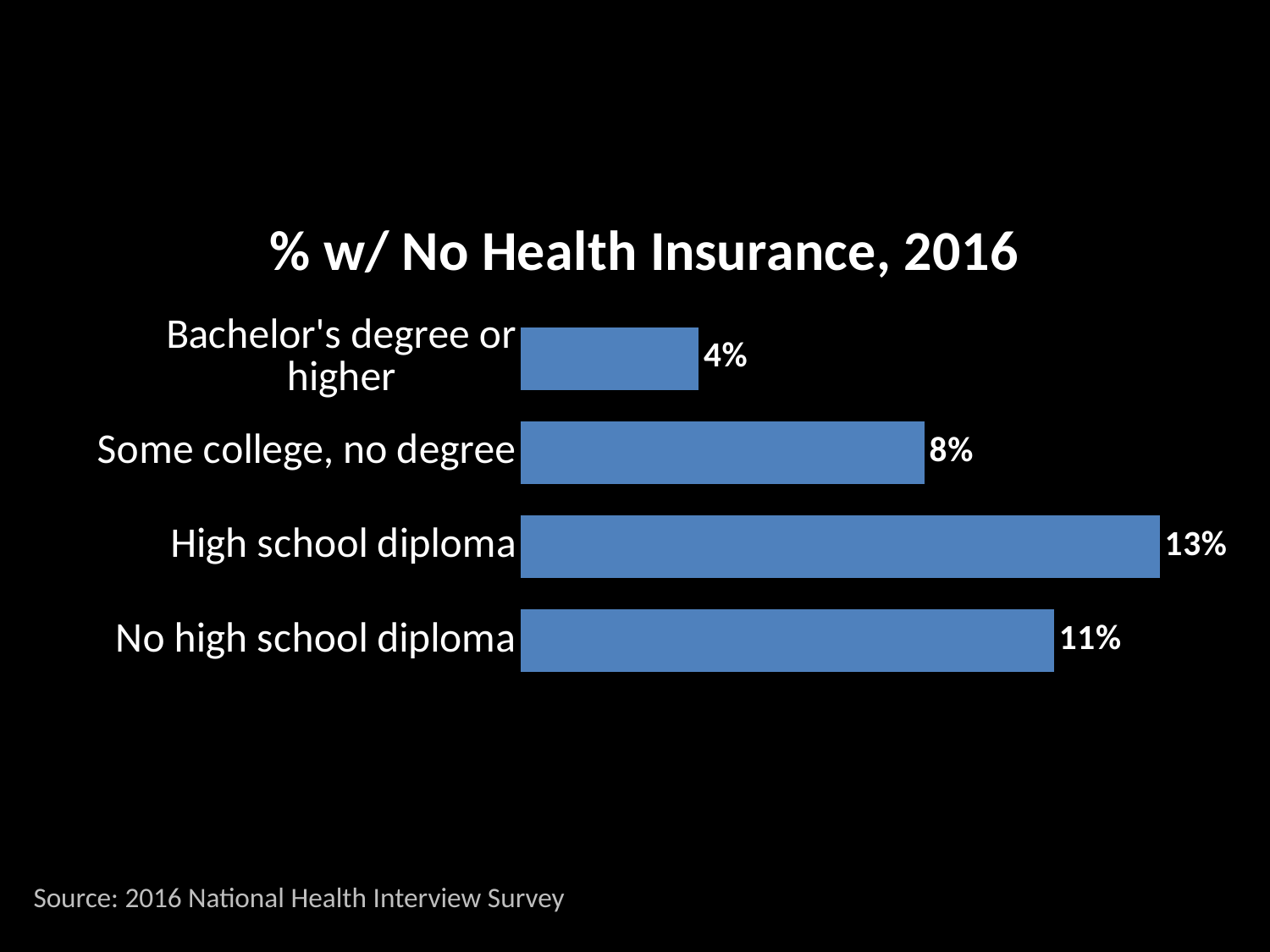
Which category has the lowest percentage with no health insurance? Bachelor's degree or higher What kind of chart is shown on the slide? Bar chart How many categories are shown in the chart? 4 What is the difference between the values for High school diploma and Bachelor's degree or higher? 9% What is the value for Bachelor's degree or higher? 4% What is the value for No high school diploma? 11% Which is larger, the value for No high school diploma or the value for High school diploma? High school diploma Which category has the highest percentage with no health insurance? High school diploma What is the difference between the values for No high school diploma and Some college, no degree? 3% What is the value for High school diploma? 13% What is the title of the chart? % w/ No Health Insurance, 2016 What is the value for Some college, no degree? 8%